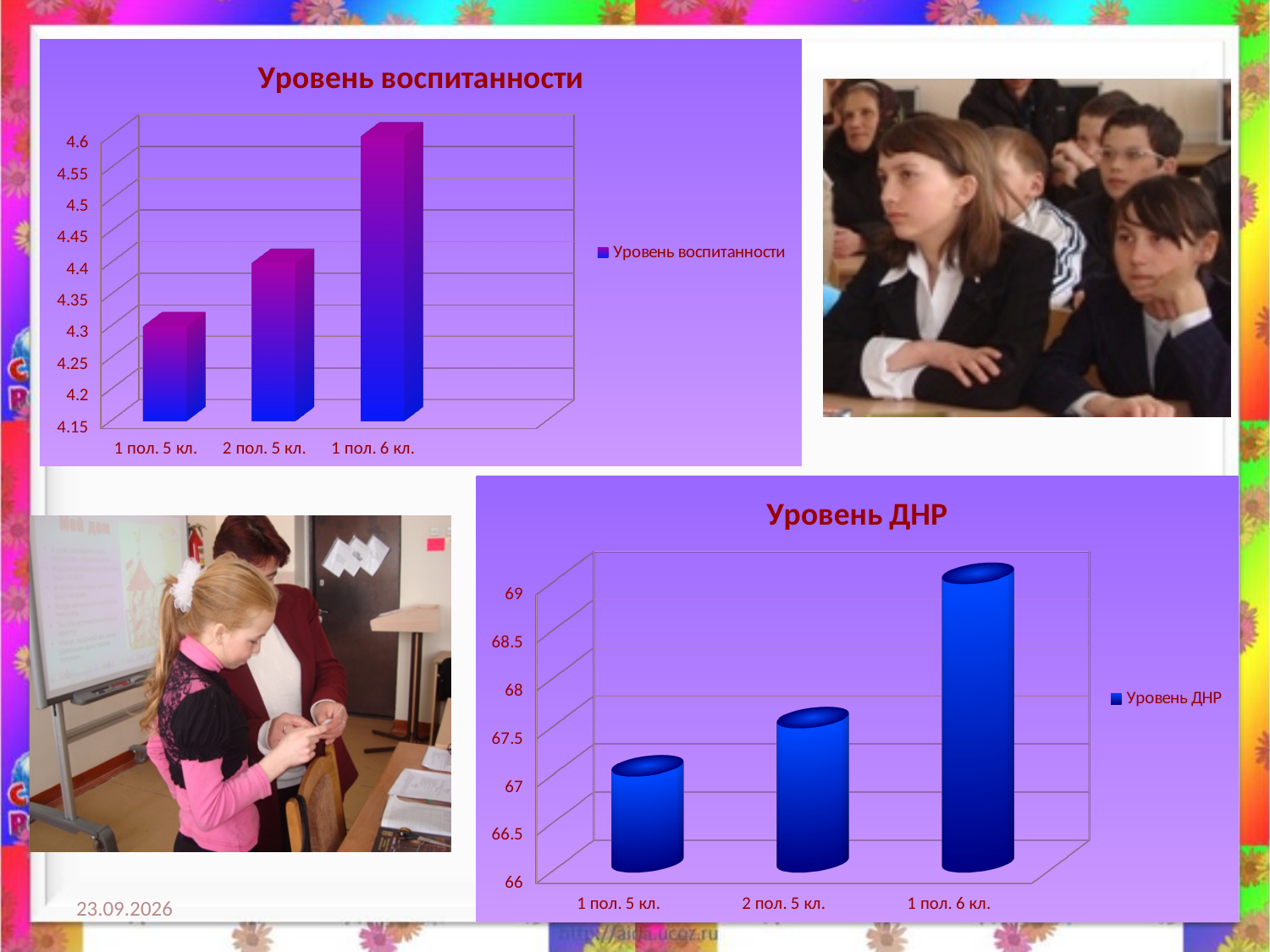
In the chart titled "Уровень воспитанности", is the value for 1 пол. 6 кл. greater or less than 4.5? greater In the chart titled "Уровень ДНР", is the value for 2 пол. 5 кл. greater or less than 68? less In the chart titled "Уровень воспитанности", is the value for 1 пол. 5 кл. greater or less than 4.4? less In the chart titled "Уровень воспитанности", which category has the lowest value? 1 пол. 5 кл. In the chart titled "Уровень ДНР", which category has the highest value? 1 пол. 6 кл. In the chart titled "Уровень воспитанности", how many categories are shown on the x axis? 3 In the chart titled "Уровень воспитанности", which category has the highest value? 1 пол. 6 кл. In the chart titled "Уровень ДНР", which is larger, the value for 2 пол. 5 кл. or the value for 1 пол. 5 кл.? 2 пол. 5 кл. What kind of chart is the chart titled "Уровень ДНР"? bar chart In the chart titled "Уровень ДНР", which category has the lowest value? 1 пол. 5 кл. In the chart titled "Уровень воспитанности", do the values rise or fall from 1 пол. 5 кл. to 1 пол. 6 кл.? rise